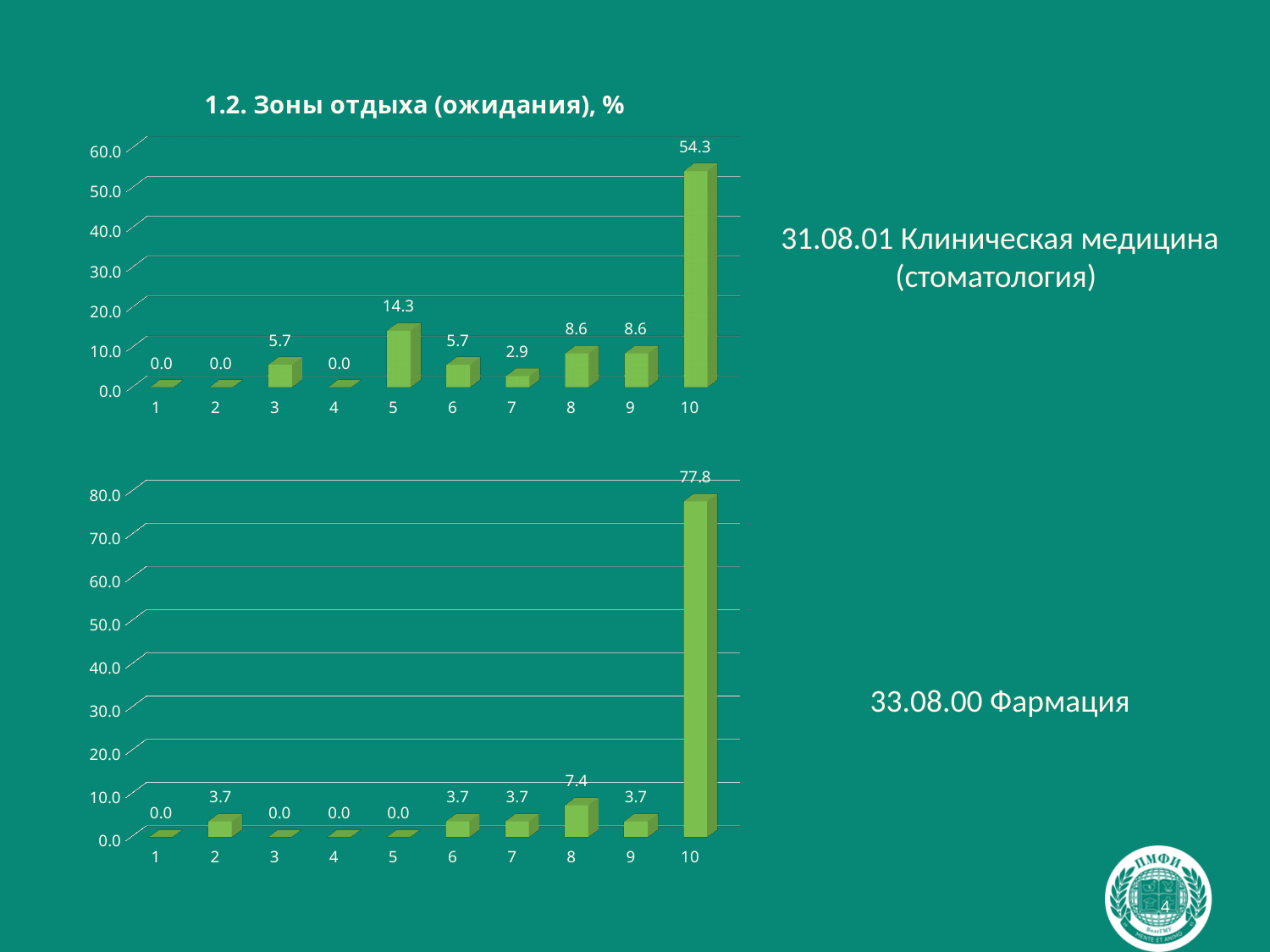
In the top chart, which category has the highest value? 10 What type of chart is the top chart? bar chart How many categories are shown on the x axis of the bottom chart? 10 In the bottom chart, which category has the highest value? 10 In the bottom chart, what is the value for category 8? 7.4 In the top chart, which is larger, the value for category 5 or the value for category 8? category 5 In the top chart, what is the value for category 10? 54.3 What is the title of the top chart? 1.2. Зоны отдыха (ожидания), % In the top chart, what is the value for category 5? 14.3 In the bottom chart, what is the value for category 10? 77.8 In the top chart, what is the difference between the values for category 10 and category 5? 40.0 In the bottom chart, what is the difference between the values for category 10 and category 8? 70.4